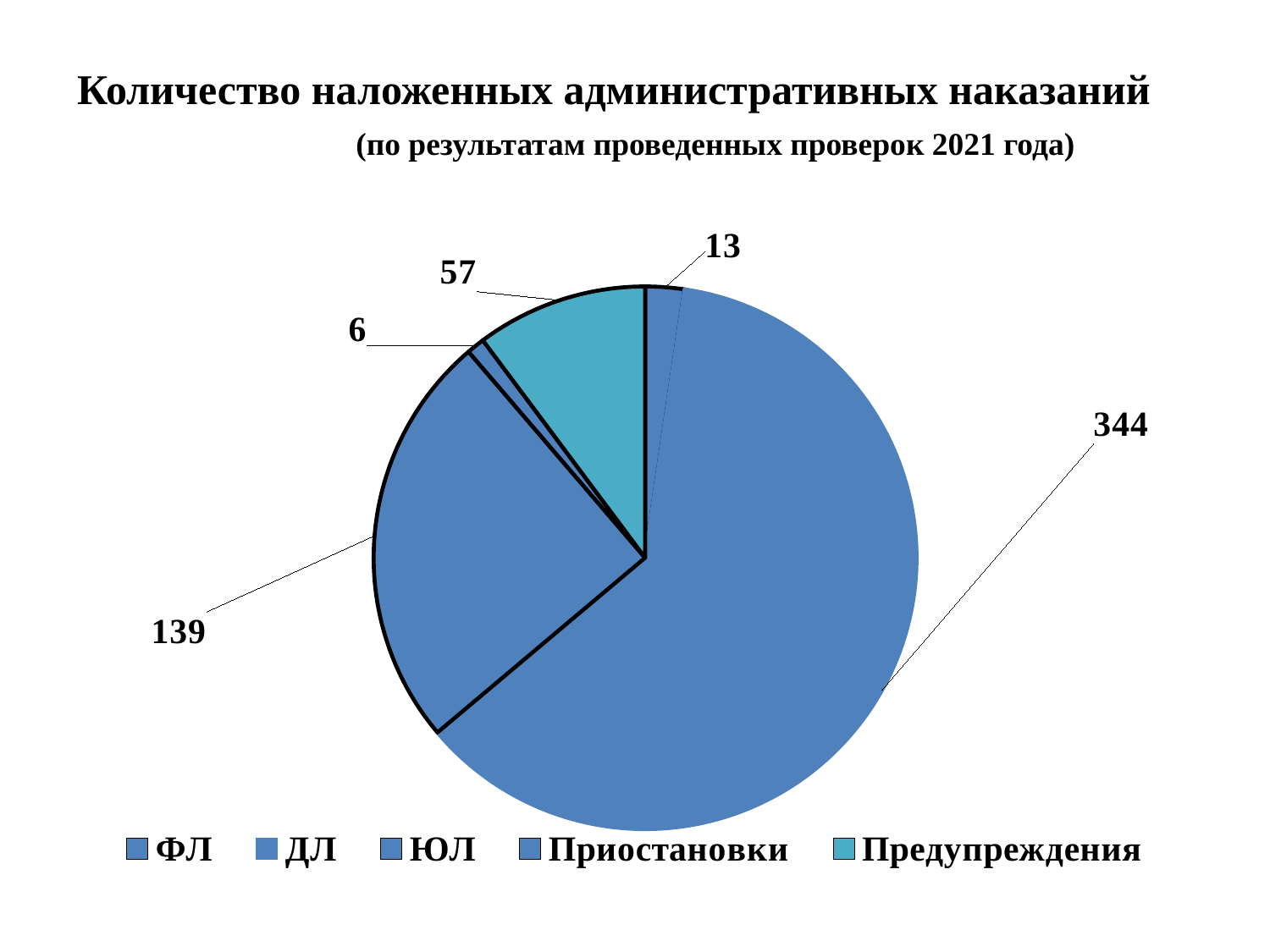
How many slices does the pie chart have? 5 What is the value of the largest slice in the pie chart? 344 What kind of chart is shown on the slide? pie chart Which legend entry is shown in teal (the lighter blue-green colour)? Предупреждения What is the value of the smallest slice in the pie chart? 6 What is the total of all slice values in the pie chart? 559 Which is larger: the slice labelled 57 or the slice labelled 13? 57 What is the value for Предупреждения in the pie chart? 57 What share of the total does the slice labelled 344 represent? 61.5% What is the difference between the two largest slices, 344 and 139? 205 How many entries does the legend of the pie chart list? 5 What is the main title of the chart? Количество наложенных административных наказаний